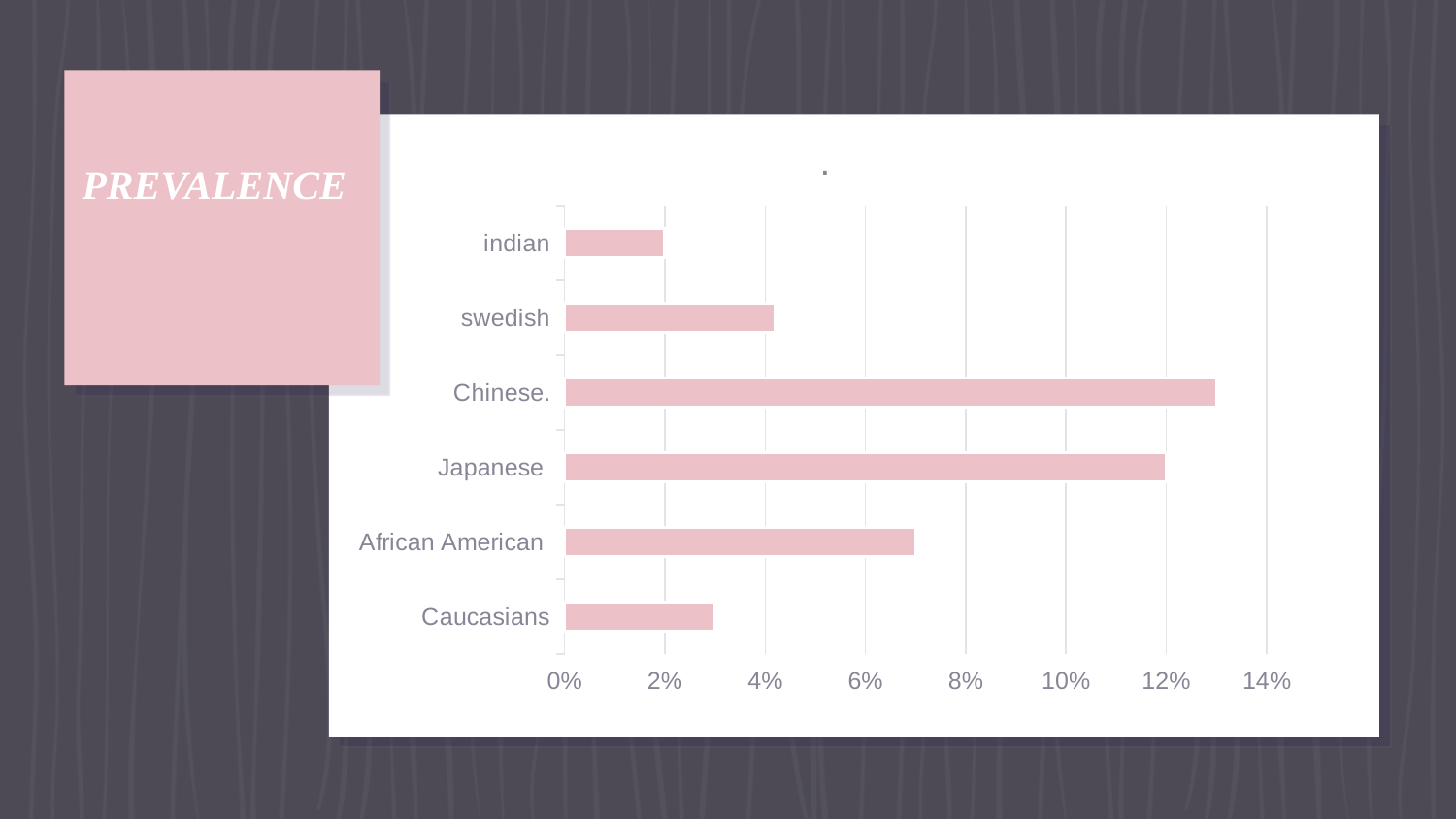
How many categories are plotted in the chart? 6 Which has the larger value, swedish or Caucasians? swedish Is the value for Chinese. greater or less than 12%? greater Is the value for Caucasians greater or less than 4%? less What is the highest tick label shown on the horizontal axis? 14% Is the value for indian greater or less than 4%? less What kind of chart is shown on the slide? bar chart Which category has the highest value in the chart? Chinese. What heading appears in the pink box to the left of the chart? PREVALENCE Which category has the lowest value in the chart? indian Which has the larger value, Japanese or African American? Japanese